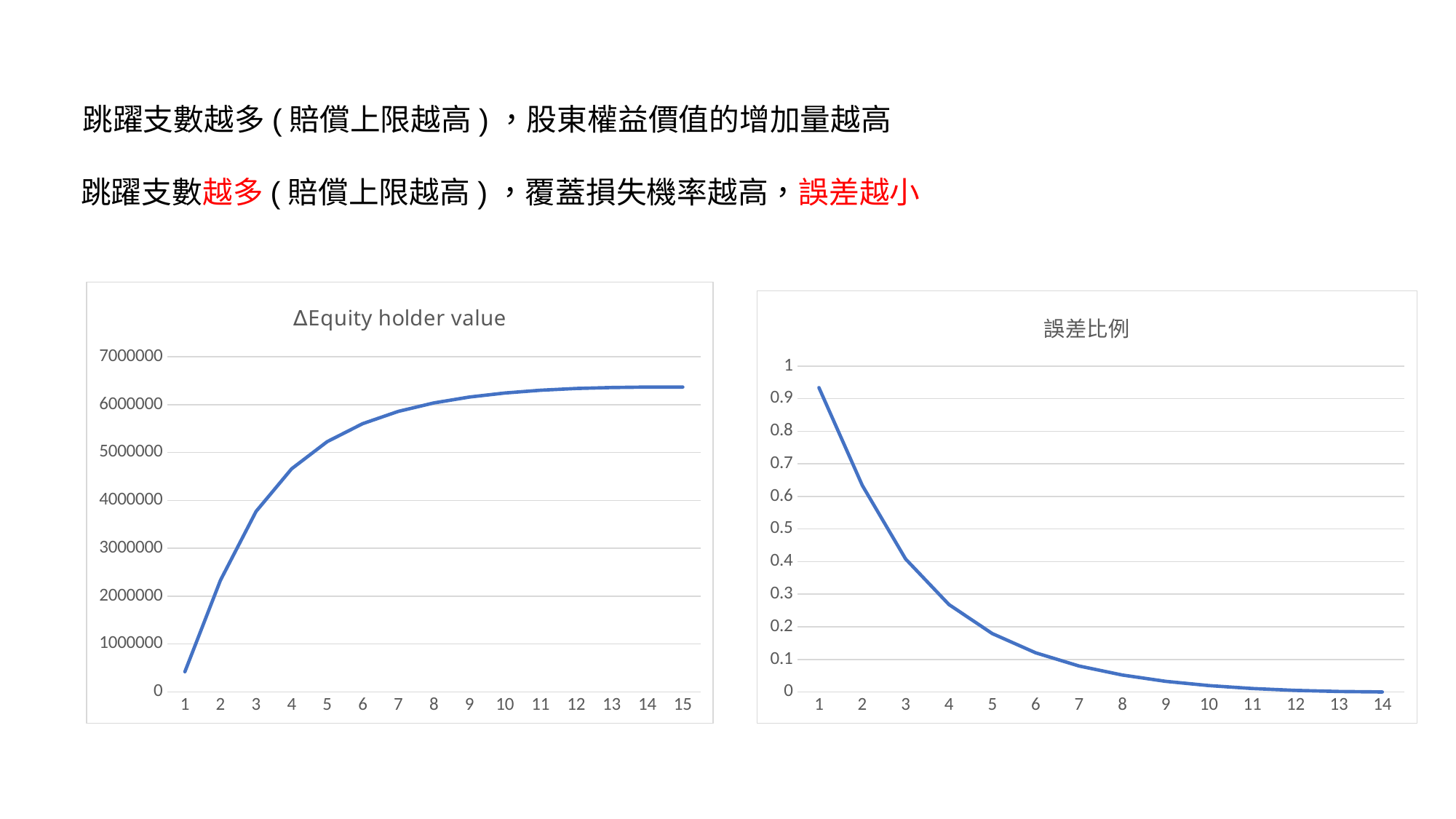
How many points are plotted on the x axis of the "誤差比例" chart? 14 What type of chart is the "誤差比例" chart? line chart In the "誤差比例" chart, is the value at x = 1 greater or less than 0.8? greater In the "誤差比例" chart, is the value at x = 14 greater or less than 0.1? less In the "ΔEquity holder value" chart, which x value has the lowest value? 1 In the "ΔEquity holder value" chart, do the values rise or fall as x increases? rise How many points are plotted on the x axis of the "ΔEquity holder value" chart? 15 What type of chart is the "ΔEquity holder value" chart? line chart In the "ΔEquity holder value" chart, is the value at x = 1 greater or less than 1000000? less In the "誤差比例" chart, which x value has the highest value? 1 In the "誤差比例" chart, do the values rise or fall as x increases? fall